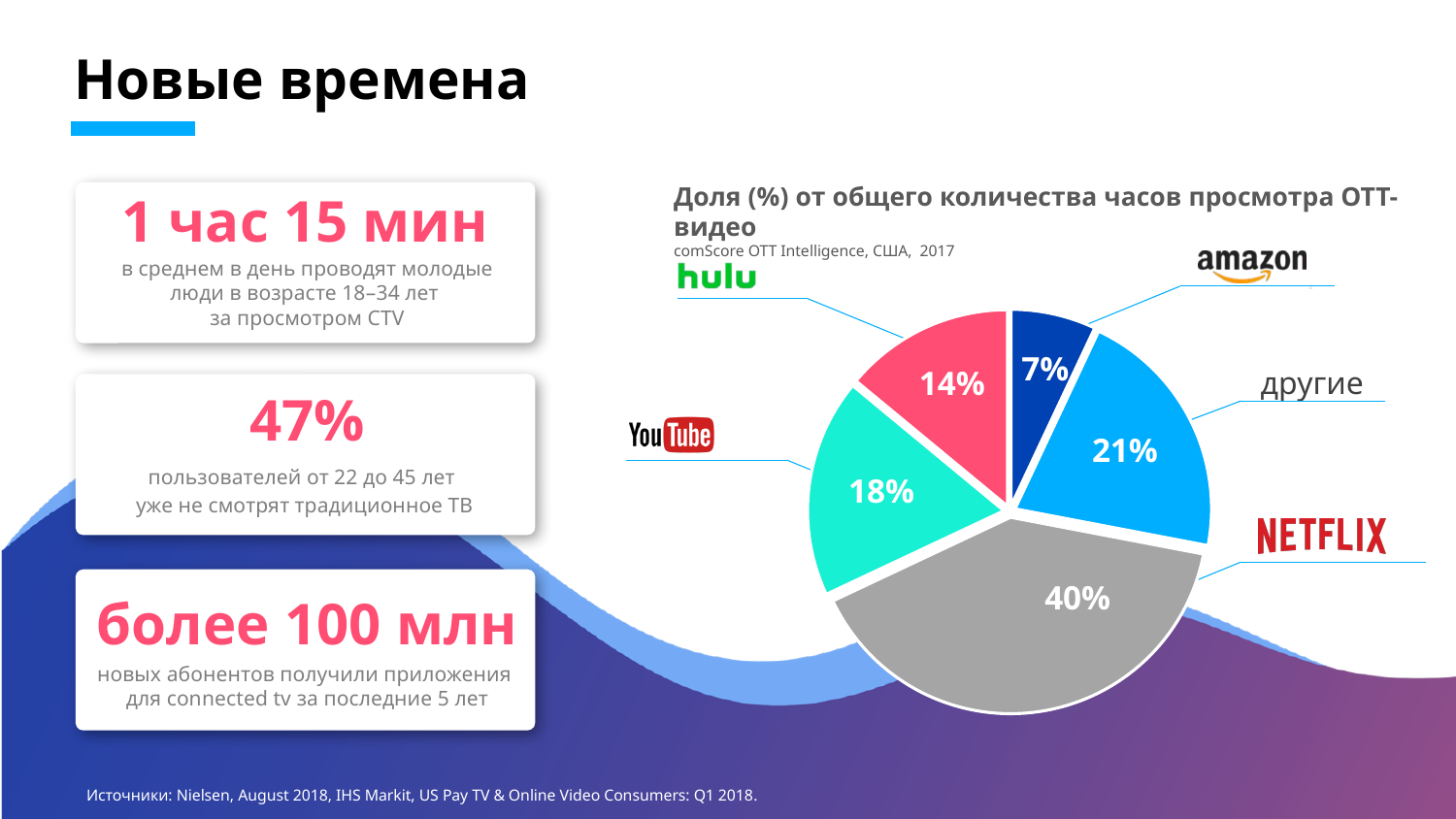
What kind of chart is shown on the slide? pie chart Which service has the smallest slice of the pie chart? amazon What share of total OTT video viewing hours does YouTube account for? 18% What share of total OTT video viewing hours is attributed to 'другие' (others)? 21% What is the difference in percentage points between the Netflix slice and the YouTube slice? 22 What share of total OTT video viewing hours does Amazon account for? 7% What share of total OTT video viewing hours does Hulu account for? 14% What is the source cited under the pie chart title? comScore OTT Intelligence, США, 2017 Which slice is larger, Hulu or YouTube? YouTube Which service has the largest slice of the pie chart? NETFLIX How many slices does the pie chart have? 5 What share of total OTT video viewing hours does Netflix account for? 40%